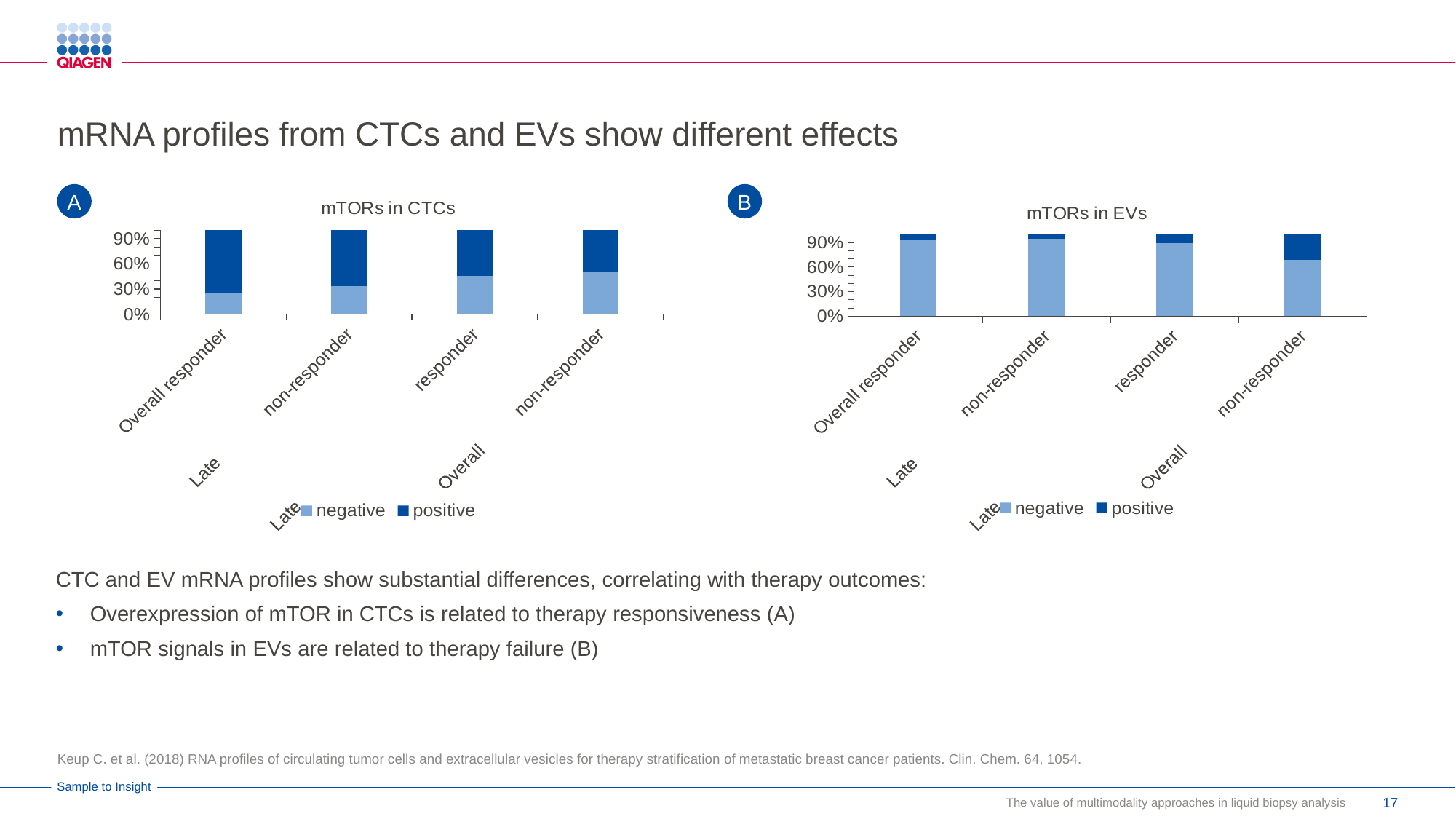
In the 'mTORs in EVs' chart, which bar has the largest positive segment? the rightmost bar (non-responder) In the 'mTORs in CTCs' chart, does the negative share rise or fall from left to right across the bars? rise In the 'mTORs in CTCs' chart, is the negative share of the rightmost bar greater or less than 30%? greater In the 'mTORs in EVs' chart, is the negative share of the leftmost bar greater or less than 60%? greater In the 'mTORs in EVs' chart, is the negative share of the rightmost bar greater or less than 90%? less How many bars are plotted in the 'mTORs in CTCs' chart? 4 In the 'mTORs in CTCs' chart, is the negative segment larger in the leftmost bar or the rightmost bar? the rightmost bar What kind of chart is the 'mTORs in CTCs' chart? stacked bar chart What is the title of the chart on the right (B)? mTORs in EVs What are the two legend entries of the 'mTORs in CTCs' chart? negative and positive How many series does the legend of the 'mTORs in EVs' chart list? 2 In the 'mTORs in EVs' chart, is the positive segment larger in the leftmost bar or the rightmost bar? the rightmost bar